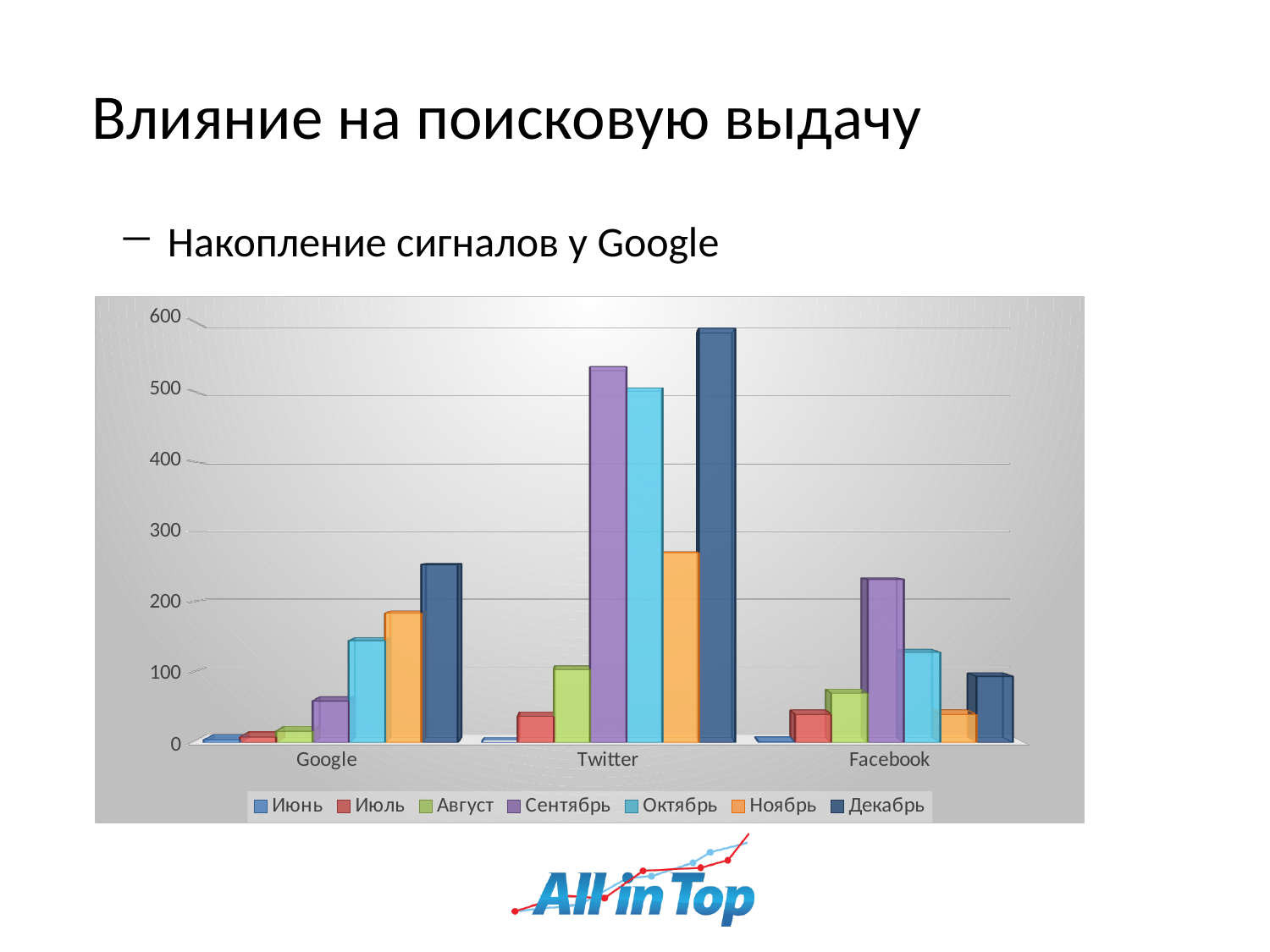
For Google, do the values rise or fall from Июнь to Декабрь? rise Is the value for Сентябрь at Facebook greater or less than 200? greater Which is larger for Google: the value for Октябрь or the value for Сентябрь? Октябрь Is the value for Декабрь at Google greater or less than 300? less For Twitter, which series has the highest value? Декабрь How many series does the chart legend list? 7 How many categories are shown on the x axis of the chart? 3 Which category has the tallest bar in the chart? Twitter Which series is shown in the darkest blue colour in the legend? Декабрь For Facebook, which series has the highest value? Сентябрь Is the value for Декабрь at Twitter greater or less than 500? greater What kind of chart is shown on the slide? bar chart